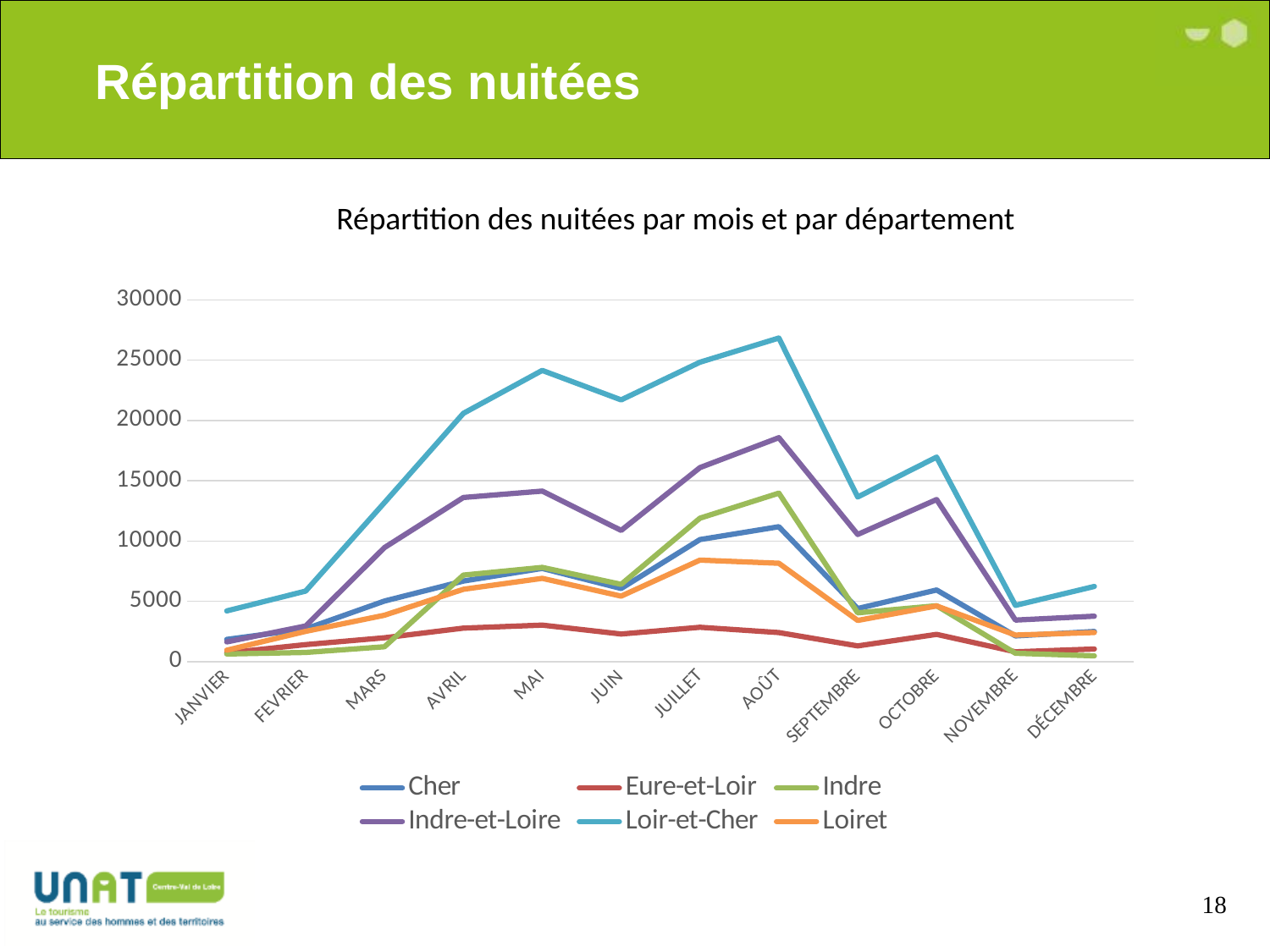
What is the title of the chart? Répartition des nuitées par mois et par département Is the value for Eure-et-Loir in JUILLET greater or less than 5000? less Which département has the lowest value in AOÛT? Eure-et-Loir How many months are shown along the x axis? 12 Is the value for Loir-et-Cher in AOÛT greater or less than 25000? greater What kind of chart is shown on the slide? line chart How many series does the legend list? 6 Which is larger in MAI, the value for Indre-et-Loire or the value for Cher? Indre-et-Loire Which département has the highest value in AOÛT? Loir-et-Cher Does the Loir-et-Cher line rise or fall from JANVIER to MAI? rise In which month does Loir-et-Cher reach its highest value? AOÛT Is the value for Indre-et-Loire in AOÛT greater or less than 20000? less